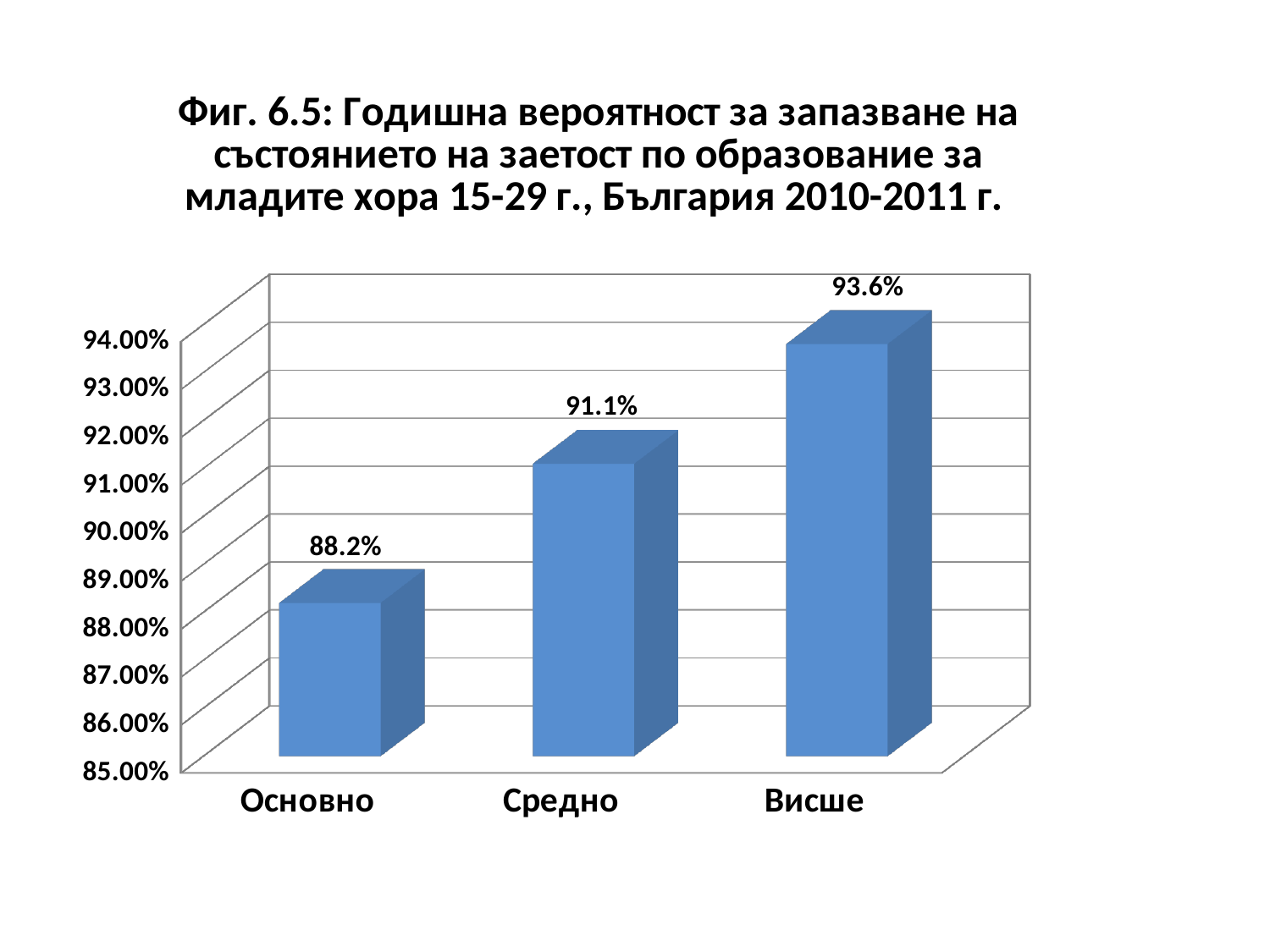
What is the value for Основно? 88.2% What is the value for Средно? 91.1% How many categories are shown on the chart? 3 Which education category has the highest value? Висше Do the values rise or fall from Основно to Висше along the x axis? rise Is the value for Основно greater or less than 90.00%? less Which is larger, the value for Средно or the value for Висше? Висше What is the value for Висше? 93.6% Which education category has the lowest value? Основно What is the difference between the values for Висше and Основно? 5.4% What kind of chart is shown on the slide? bar chart What is the difference between the values for Средно and Основно? 2.9%